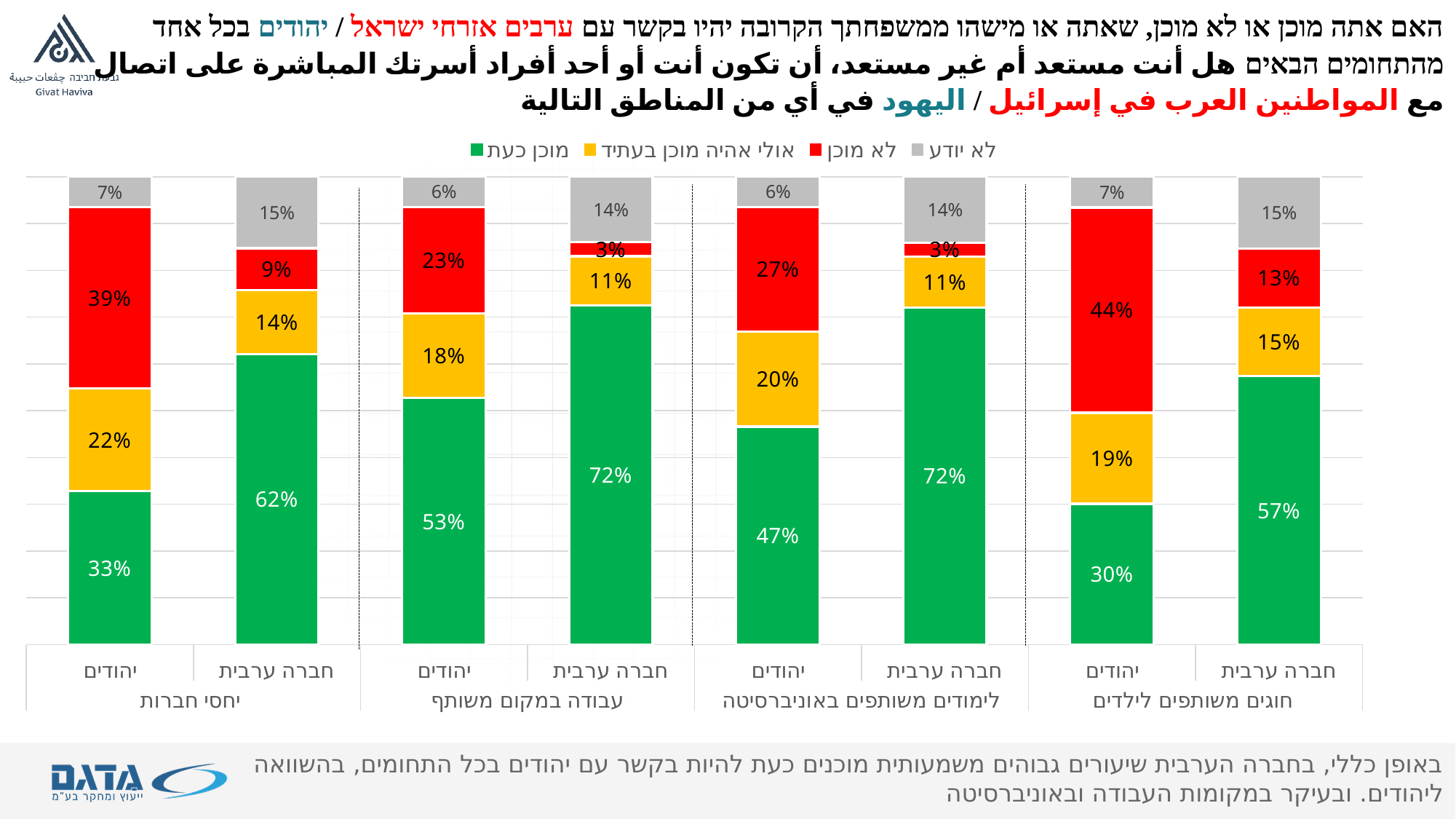
Which colour represents the לא מוכן series in the chart? red What is the value of לא יודע for חברה ערבית in the חוגים משותפים לילדים group? 15% What is the value of מוכן כעת for יהודים in the יחסי חברות group? 33% How many bars are plotted in the chart? 8 Which bar has the highest מוכן כעת value? חברה ערבית in עבודה במקום משותף and לימודים משותפים באוניברסיטה (72%) What is the difference between the מוכן כעת values for חברה ערבית and יהודים in the יחסי חברות group? 29% Which is larger: the לא מוכן value for יהודים in עבודה במקום משותף or for יהודים in לימודים משותפים באוניברסיטה? יהודים in לימודים משותפים באוניברסיטה (27%) How many series does the legend list? 4 Which bar has the lowest מוכן כעת value? יהודים in חוגים משותפים לילדים (30%) What is the value of לא מוכן for יהודים in the חוגים משותפים לילדים group? 44% What kind of chart is shown on the slide? stacked bar chart What is the value of אולי אהיה מוכן בעתיד for חברה ערבית in the לימודים משותפים באוניברסיטה group? 11%